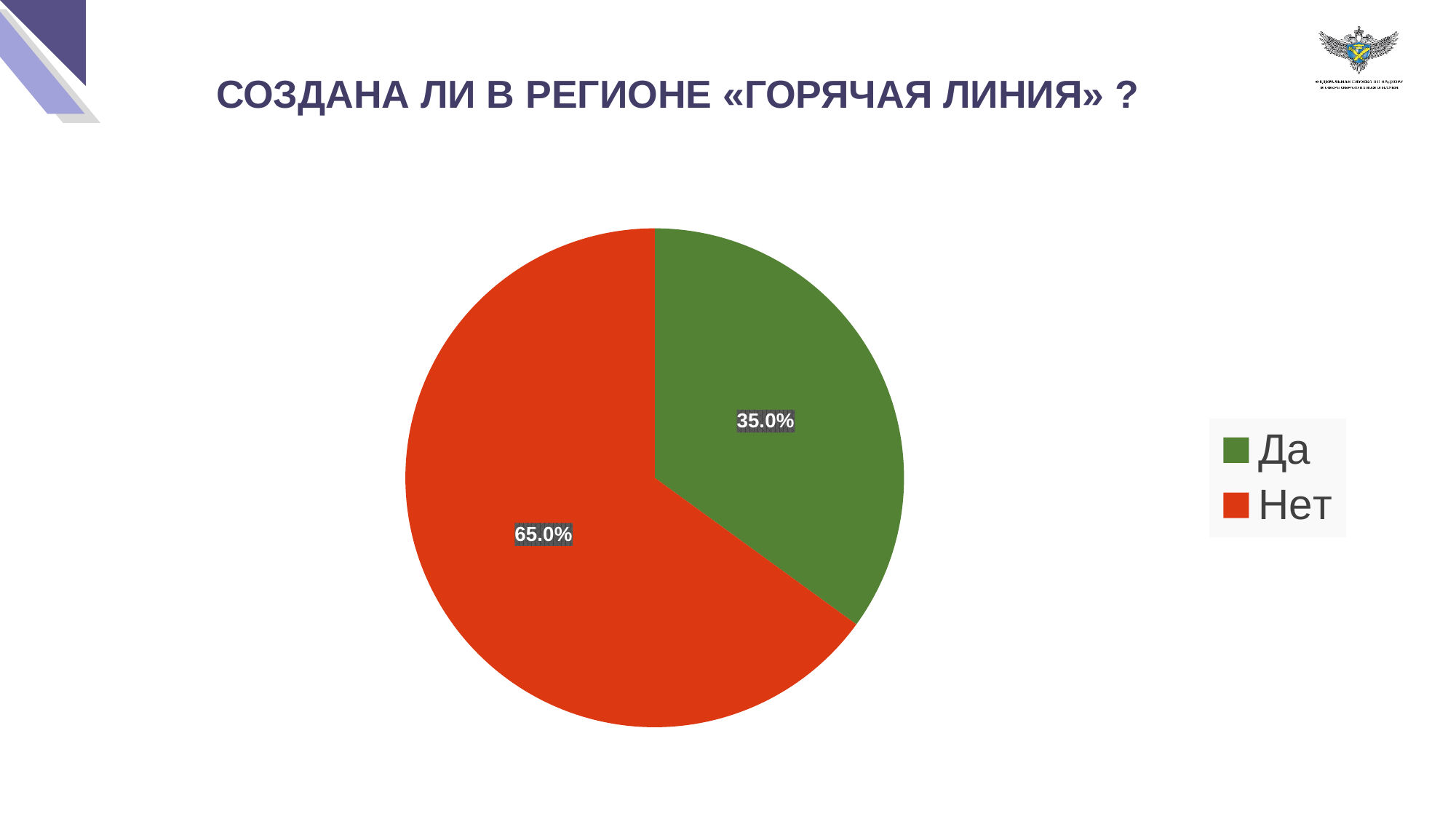
What is the title of the slide above the chart? СОЗДАНА ЛИ В РЕГИОНЕ «ГОРЯЧАЯ ЛИНИЯ» ? What kind of chart is shown on the slide? Pie chart How many entries does the legend list? 2 Which slice is the smallest in the pie chart? Да What is the difference in percentage points between the "Нет" and "Да" slices? 30.0% Which is larger, the "Да" slice or the "Нет" slice? Нет What colour is the "Нет" slice? Red What share of the pie does the "Нет" slice represent? 65.0% How many slices does the pie chart have? 2 What share of the pie does the "Да" slice represent? 35.0% Which slice is the largest in the pie chart? Нет